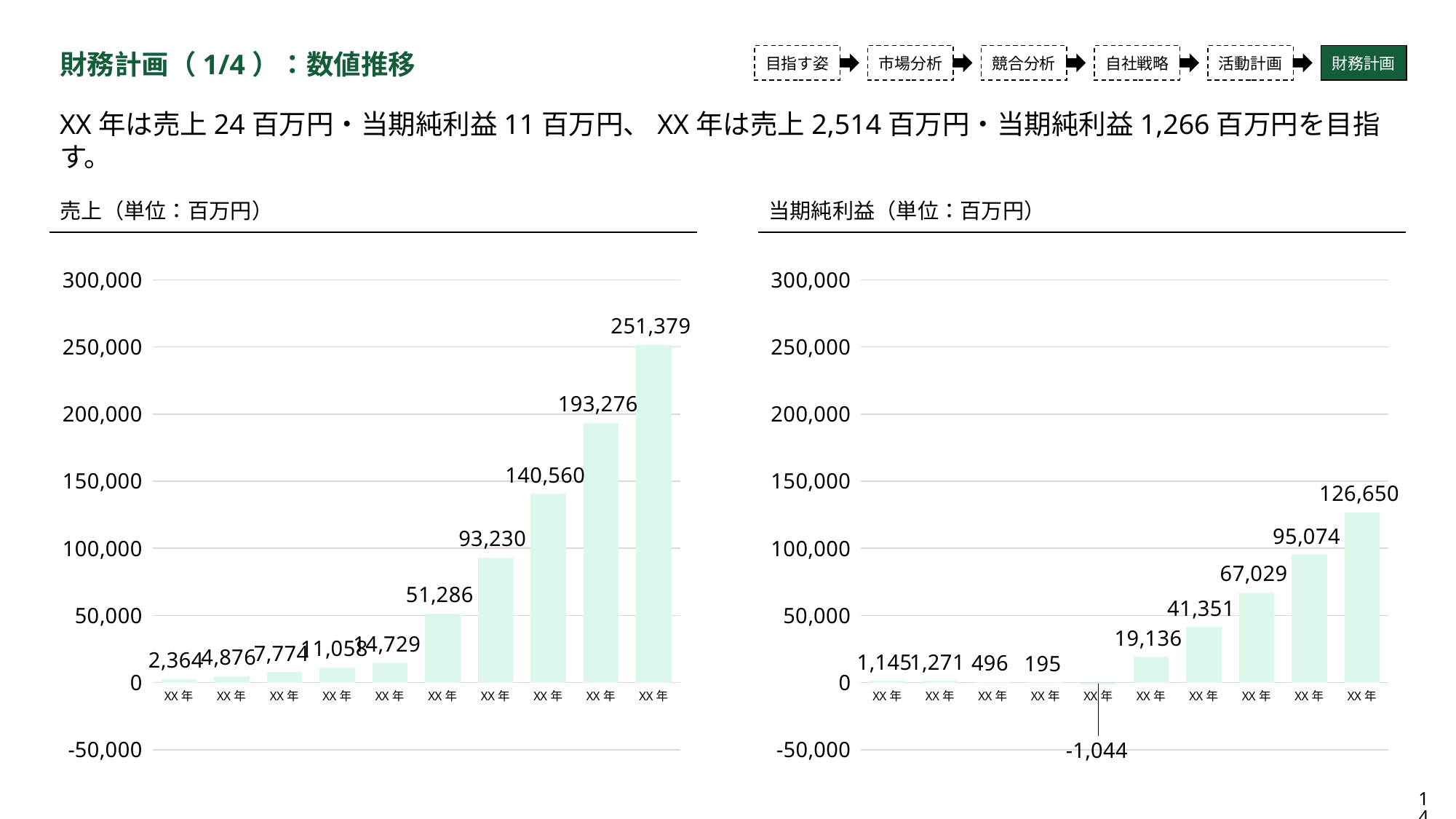
What kind of chart is the 売上（単位：百万円） chart on the left? bar chart In the 当期純利益（単位：百万円） chart, what is the lowest value shown? -1,044 How many bars are plotted in the 売上（単位：百万円） chart? 10 In the 売上（単位：百万円） chart, do the values rise or fall from left to right? rise In the 当期純利益（単位：百万円） chart, how many bars have a negative value? 1 What unit is stated in the titles of both charts? 百万円 In the 売上（単位：百万円） chart, what is the value of the rightmost bar? 251,379 In the 売上（単位：百万円） chart, what is the difference between the rightmost bar and the second bar from the right? 58,103 In the 当期純利益（単位：百万円） chart, what is the value of the rightmost bar? 126,650 Which is larger: the rightmost bar of the 売上 chart or the rightmost bar of the 当期純利益 chart? the rightmost bar of the 売上 chart In the 売上（単位：百万円） chart, what is the value of the second bar from the right? 193,276 In the 当期純利益（単位：百万円） chart, what is the difference between the rightmost bar (126,650) and the bar just left of it (95,074)? 31,576